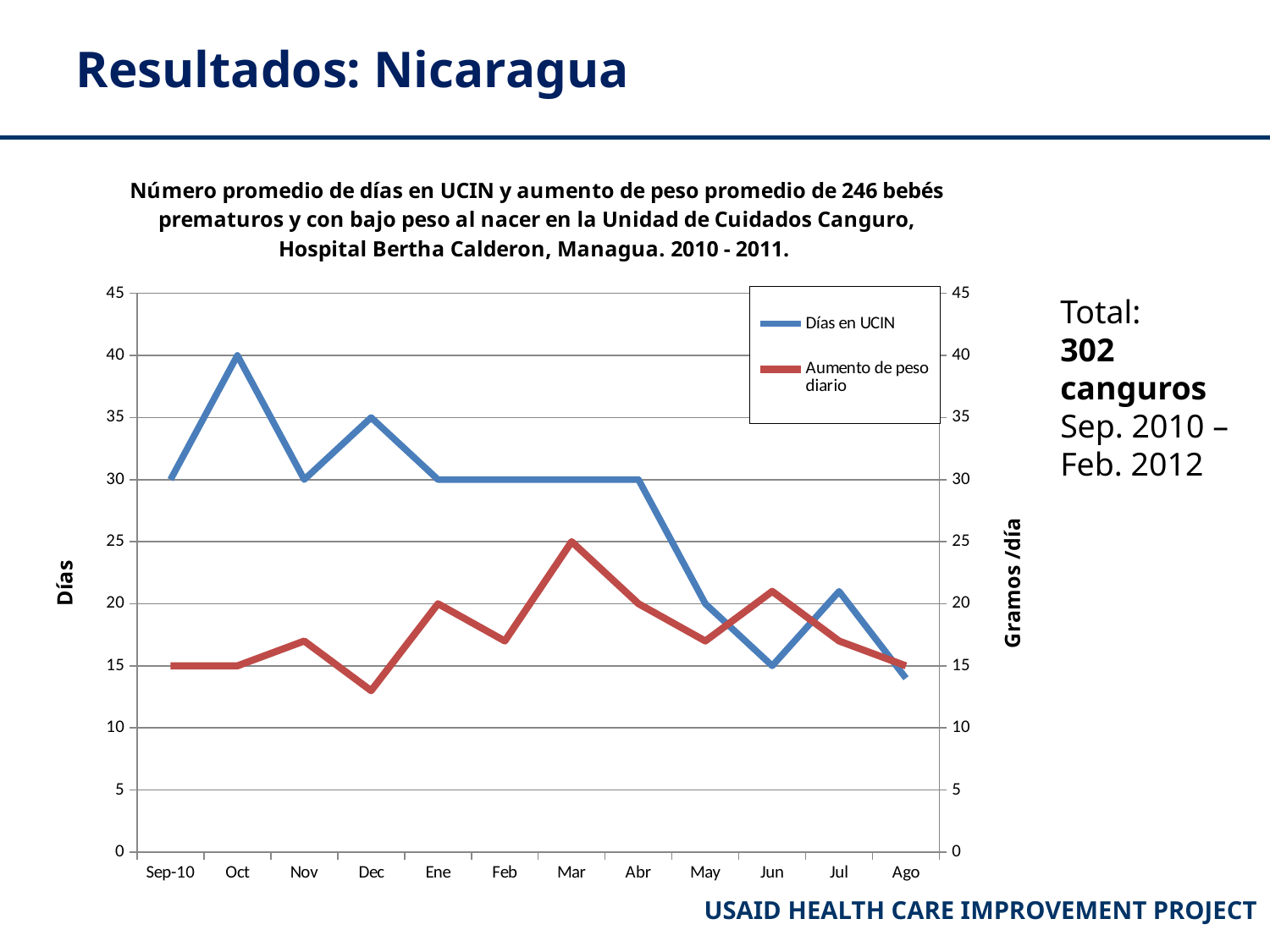
In which month is Días en UCIN highest? Oct In which month is Aumento de peso diario highest? Mar How many series does the legend list? 2 Is the value of Aumento de peso diario in Dec greater or less than 15? less In Sep-10, which series has the larger value, Días en UCIN or Aumento de peso diario? Días en UCIN What is the title of the right-hand vertical axis? Gramos /día What is the value of Días en UCIN in Oct? 40 What is the value of Aumento de peso diario in Mar? 25 How many months are plotted along the x axis? 12 What kind of chart is shown on the slide? Line chart In which month is Aumento de peso diario lowest? Dec What is the difference between Días en UCIN in Oct and in Jun? 25